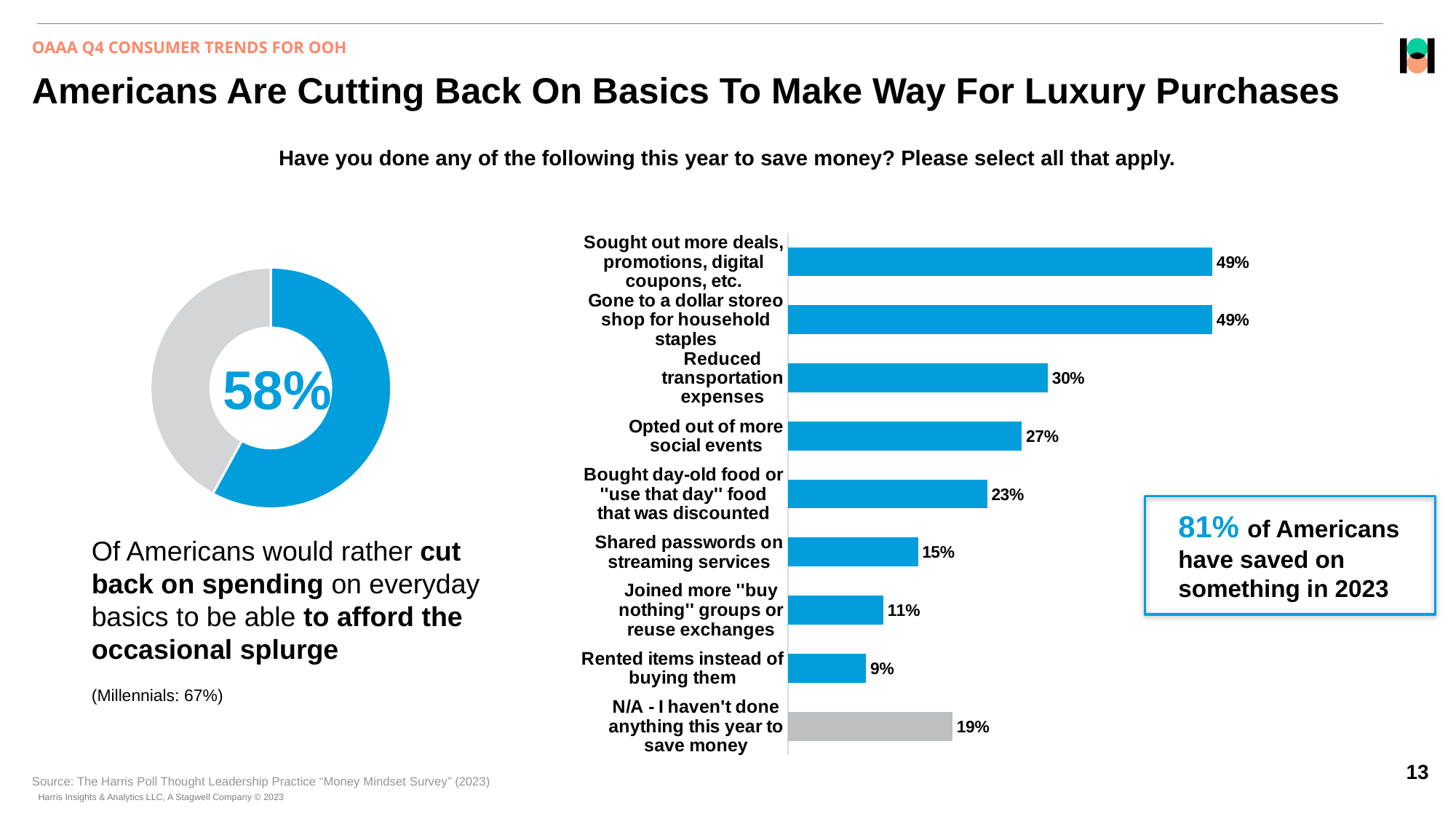
In the bar chart, what percentage shared passwords on streaming services? 15% In the bar chart, what is the highest value shown? 49% In the donut chart on the left, what share of Americans would rather cut back on spending on everyday basics to afford the occasional splurge? 58% What kind of chart is on the left side of the slide? Donut chart In the bar chart, what is the difference between 'Opted out of more social events' and 'Bought day-old food or "use that day" food that was discounted'? 4% In the bar chart, which is larger: 'Joined more "buy nothing" groups or reuse exchanges' or 'Rented items instead of buying them'? Joined more "buy nothing" groups or reuse exchanges What kind of chart is on the right side of the slide? Bar chart In the bar chart, which category has the lowest value? Rented items instead of buying them In the bar chart, what percentage of respondents sought out more deals, promotions, digital coupons, etc.? 49% In the bar chart, what percentage reduced transportation expenses? 30% In the bar chart, what percentage said they haven't done anything this year to save money? 19% How many categories does the bar chart show? 9